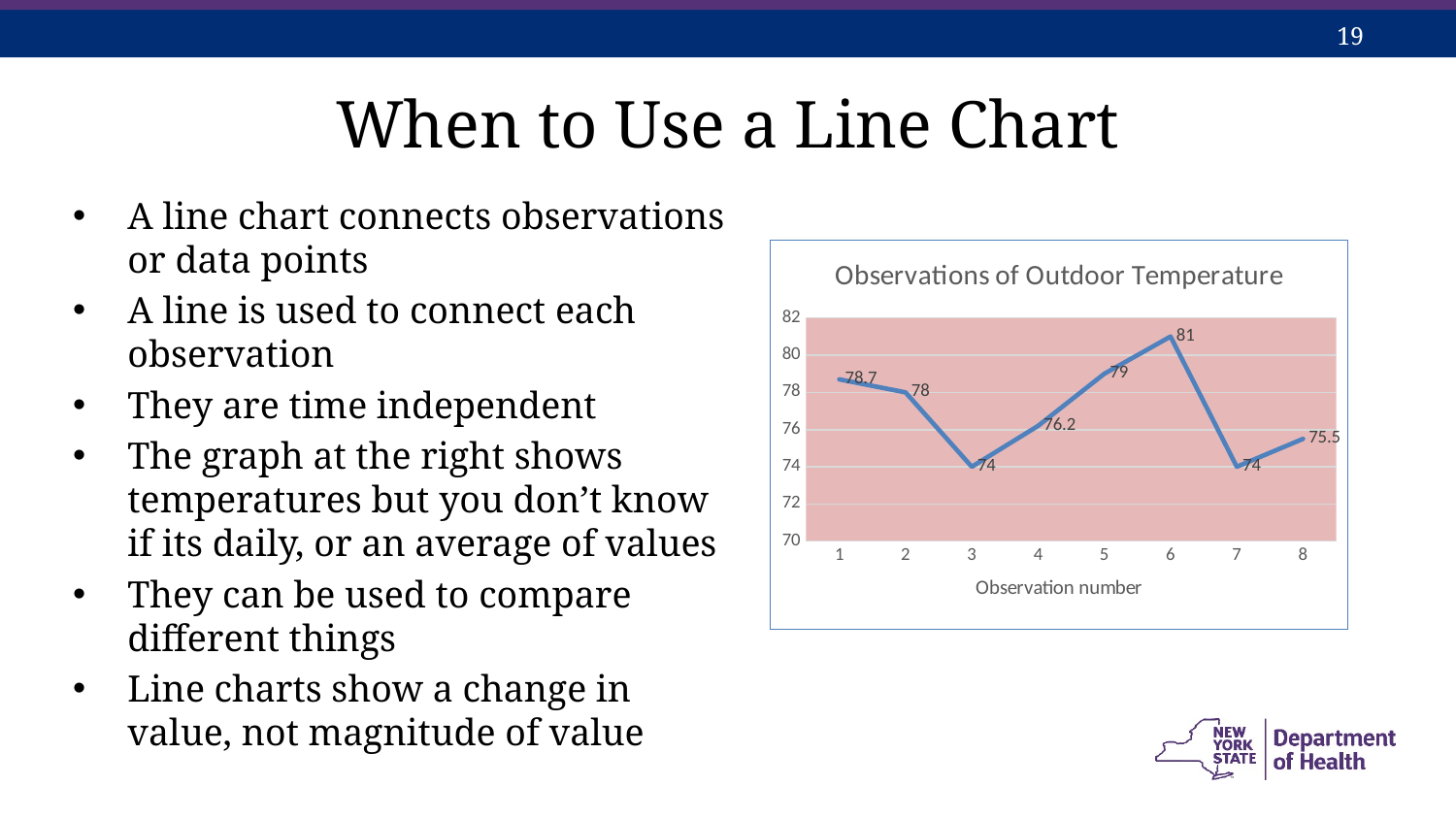
What is the lowest temperature value shown on the chart? 74 What is the difference between the temperature at observation 6 and the temperature at observation 7? 7 What is the title of the chart? Observations of Outdoor Temperature Does the temperature rise or fall from observation 2 to observation 3? Fall What is the temperature value at observation number 6? 81 What is the temperature value at observation number 1? 78.7 How many observations are plotted on the chart? 8 Which has a higher temperature value, observation 4 or observation 5? Observation 5 What is the temperature value at observation number 8? 75.5 What kind of chart is shown on the slide? Line chart Is the value for observation 2 greater or less than 76? greater Which observation number has the highest temperature? 6